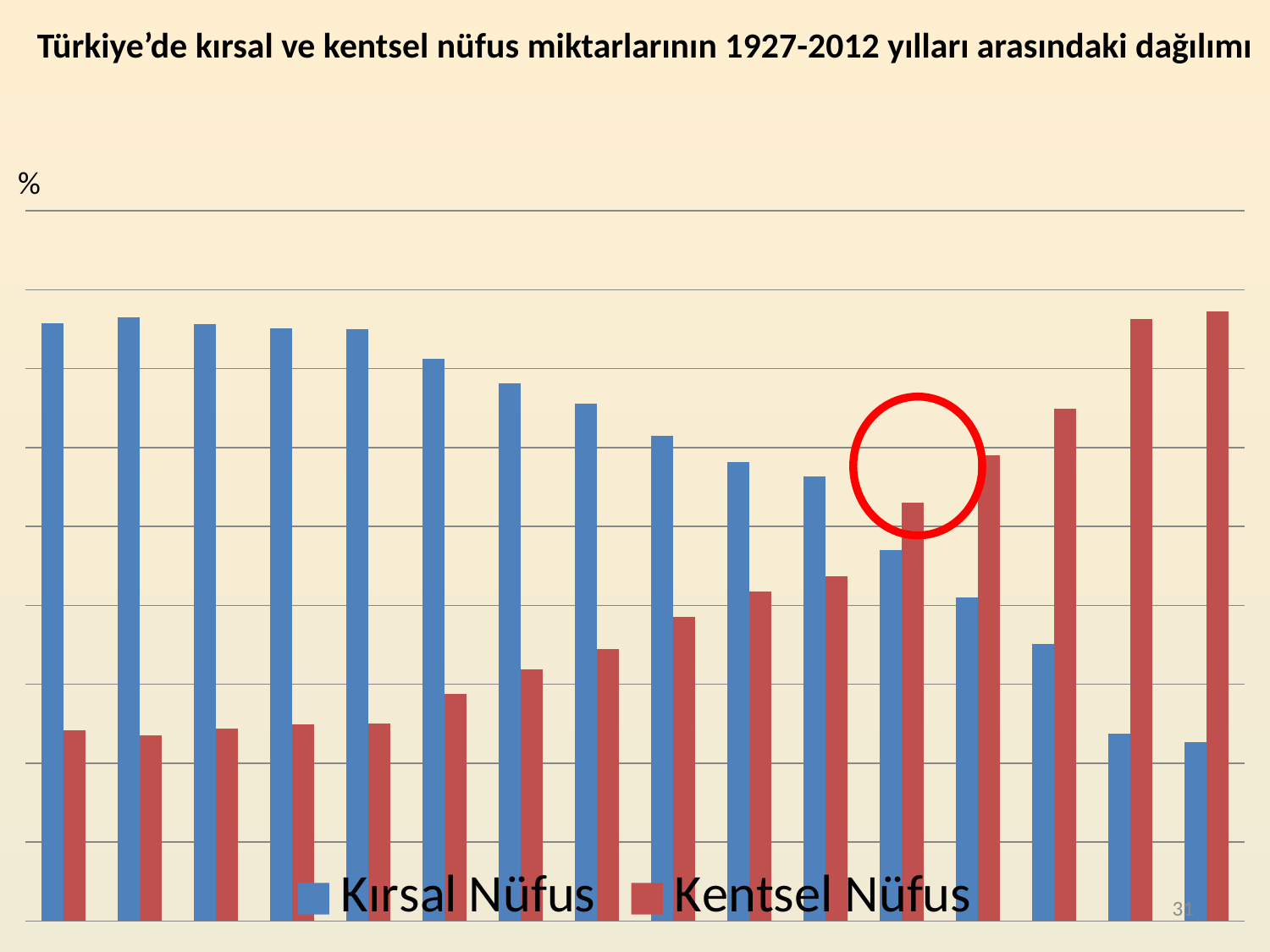
How many series does the legend list? 2 How many groups of bars (categories) are plotted in the chart? 16 What are the two series named in the legend? Kırsal Nüfus and Kentsel Nüfus In the leftmost group of bars, which series has the larger value, Kırsal Nüfus or Kentsel Nüfus? Kırsal Nüfus Which colour represents Kentsel Nüfus in the chart? red In the rightmost group of bars, which series has the larger value, Kırsal Nüfus or Kentsel Nüfus? Kentsel Nüfus Do the Kırsal Nüfus values rise or fall from left to right along the x axis? fall Which series has the lowest bar in the chart? Kırsal Nüfus What kind of chart is shown on the slide? bar chart Do the Kentsel Nüfus values rise or fall from left to right along the x axis? rise